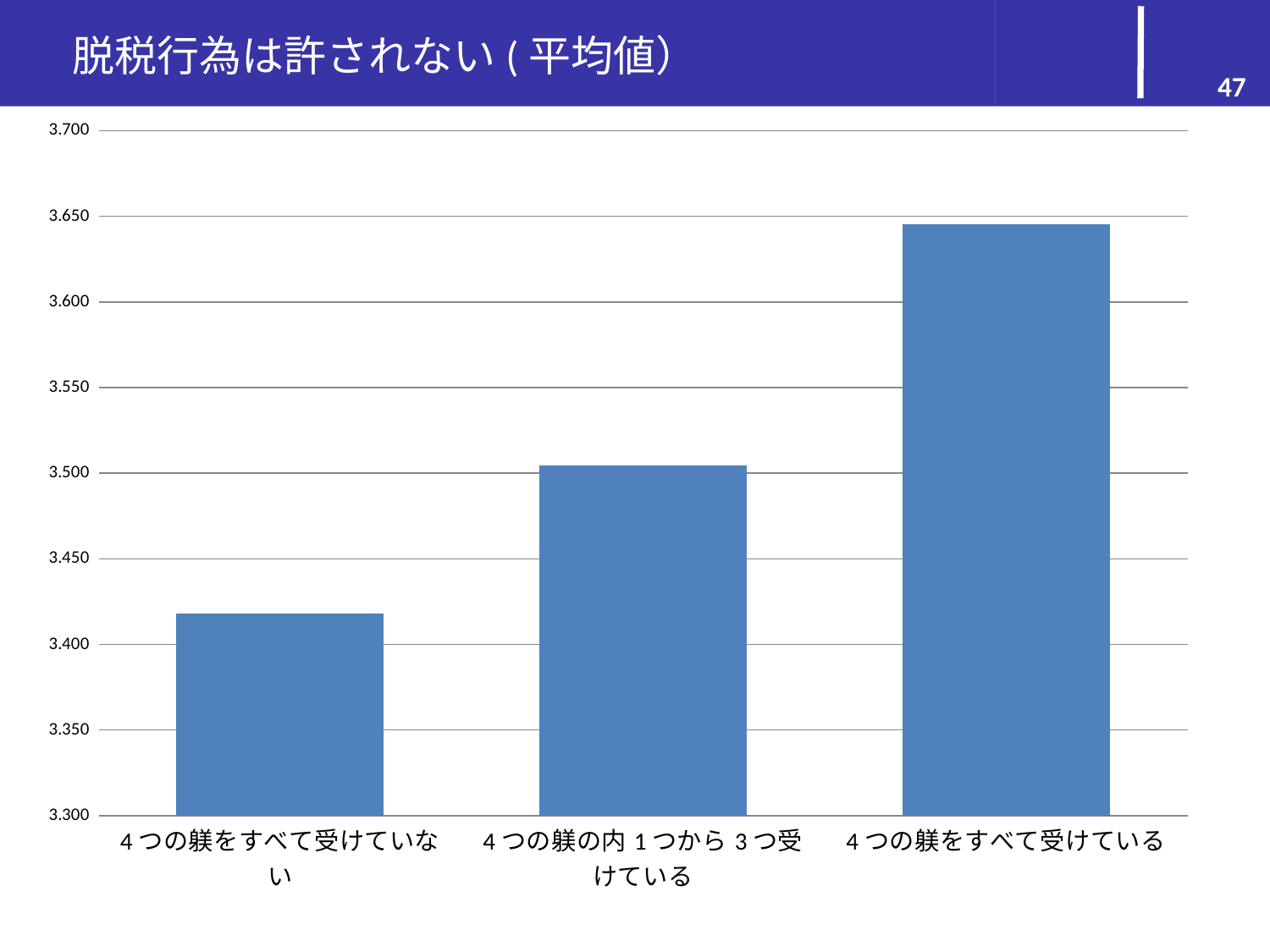
Is the value for 4つの躾をすべて受けている greater or less than 3.600? greater What is the title of the slide containing the chart? 脱税行為は許されない(平均値) How many categories are shown on the x axis of the chart? 3 Which is larger: the value for 4つの躾をすべて受けていない or the value for 4つの躾の内1つから3つ受けている? 4つの躾の内1つから3つ受けている Is the value for 4つの躾をすべて受けていない greater or less than 3.400? greater Which category has the lowest value in the chart? 4つの躾をすべて受けていない Is the value for 4つの躾の内1つから3つ受けている greater or less than 3.550? less Do the values rise or fall moving from left to right along the x axis? rise What kind of chart is shown on the slide? bar chart Which category has the highest value in the chart? 4つの躾をすべて受けている Which is larger: the value for 4つの躾の内1つから3つ受けている or the value for 4つの躾をすべて受けている? 4つの躾をすべて受けている